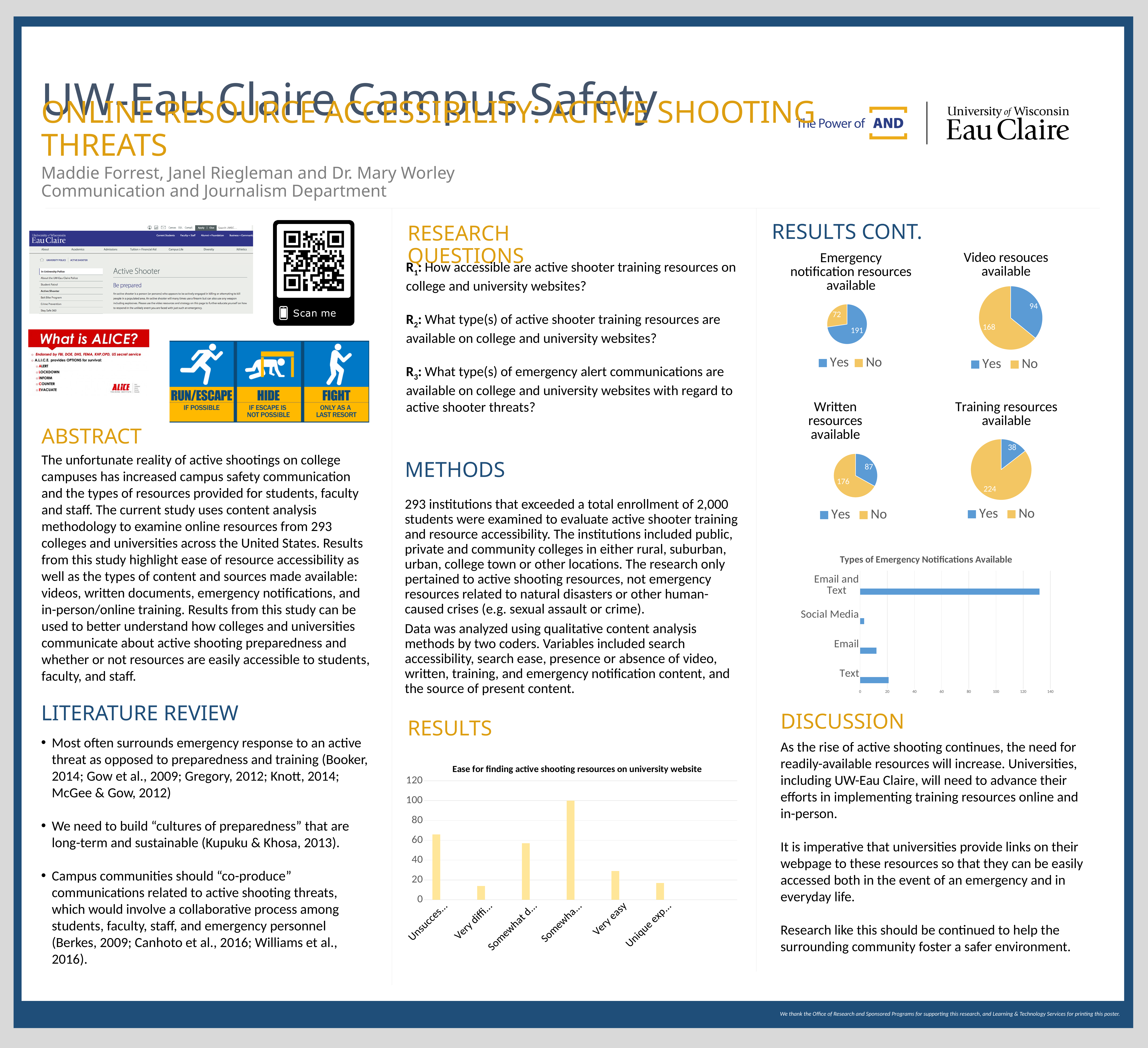
In the 'Emergency notification resources available' pie chart, what is the value for No? 72 How many bars are shown in the 'Ease for finding active shooting resources on university website' chart? 6 In the 'Types of Emergency Notifications Available' bar chart, which category has the highest value? Email and Text In the 'Emergency notification resources available' pie chart, what is the value for Yes? 191 In the 'Training resources available' pie chart, what is the value for No? 224 In the 'Written resources available' pie chart, what is the difference between the No and Yes values? 89 In the 'Training resources available' pie chart, which slice is larger, Yes or No? No In the 'Video resouces available' pie chart, what is the value for Yes? 94 In the 'Types of Emergency Notifications Available' bar chart, is the value for Email and Text greater or less than 120? greater In the 'Ease for finding active shooting resources on university website' chart, is the value for Very easy greater or less than 40? less In the 'Emergency notification resources available' pie chart, which slice is larger, Yes or No? Yes In the 'Types of Emergency Notifications Available' bar chart, which category has the lowest value? Social Media